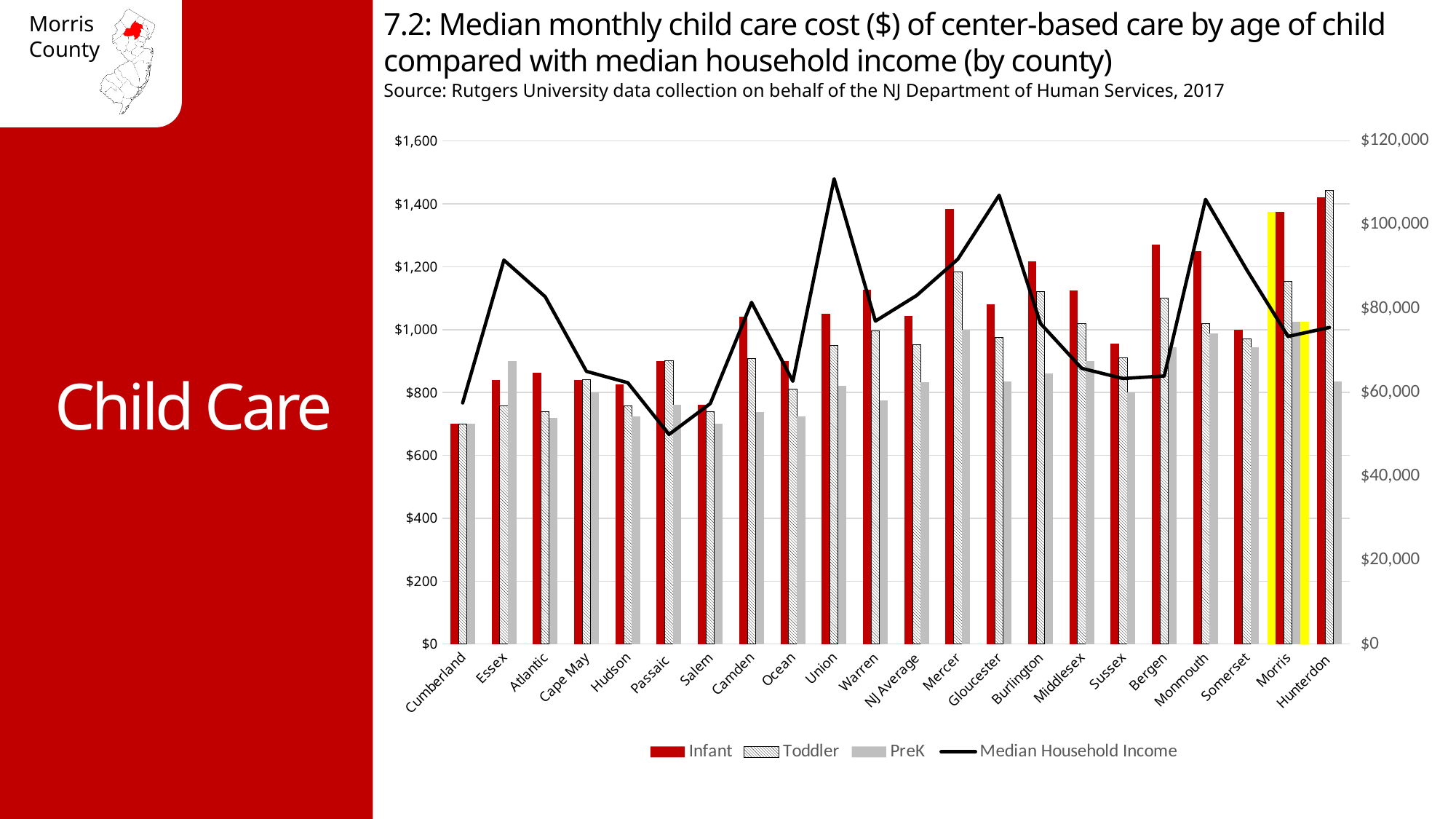
How many counties/categories are shown along the x axis of the chart? 22 What kind of chart is used to show the child care costs on this slide? Bar chart (with a line for median household income) Which county has the highest Median Household Income on the line? Union Is the Median Household Income for Passaic greater or less than $60,000? less Is the Infant cost for Mercer greater or less than $1,200? greater How many series does the chart's legend list? 4 Which county's bars are highlighted in yellow on the chart? Morris For Essex, which is larger: the Toddler cost or the PreK cost? PreK Which county has the lowest Infant child care cost? Cumberland Which county has the lowest Median Household Income on the line? Passaic Is the Infant cost for Cumberland greater or less than $800? less Which county has the highest Infant child care cost? Hunterdon